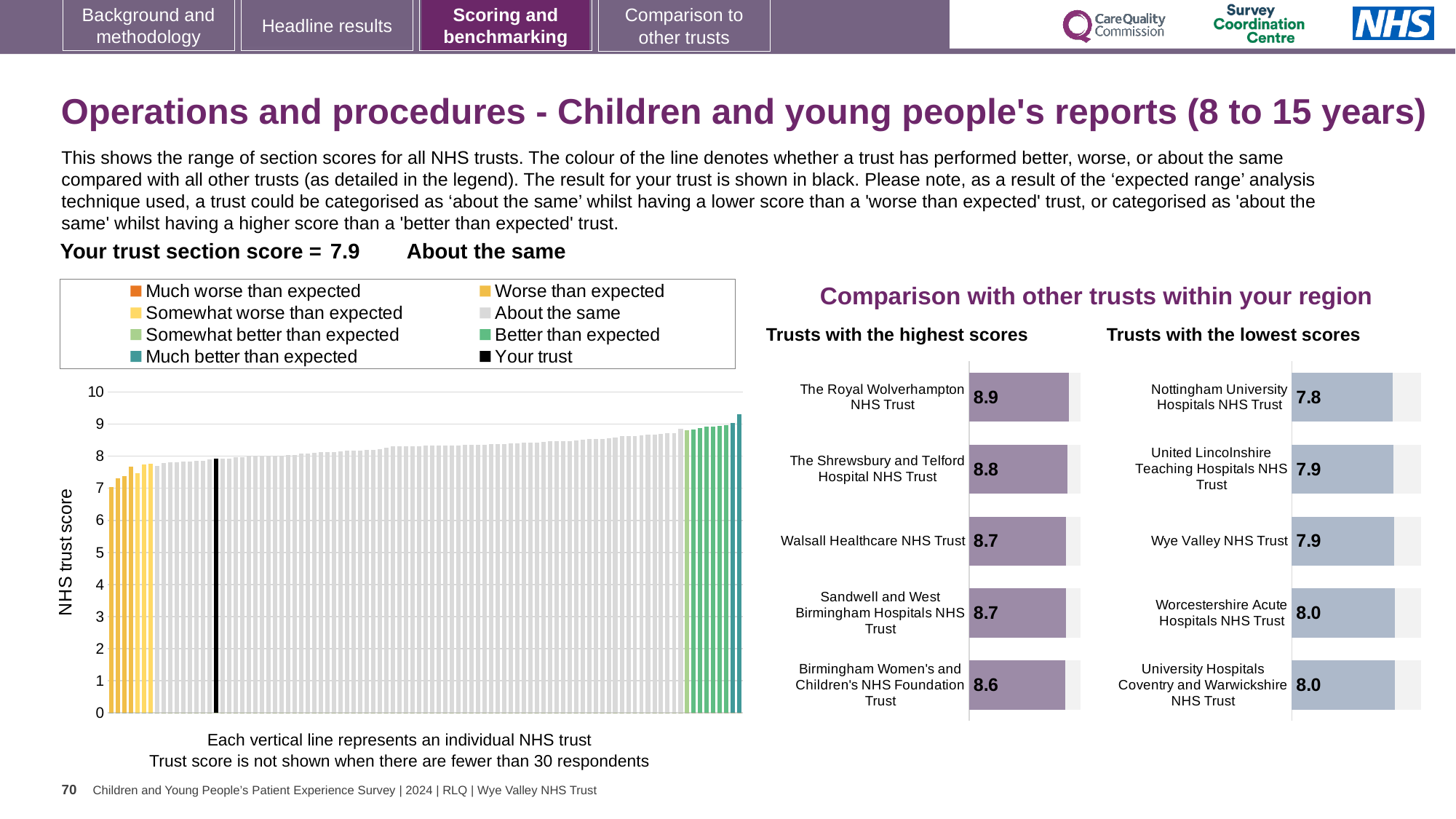
In the 'Trusts with the lowest scores' chart, what is the score for Worcestershire Acute Hospitals NHS Trust? 8.0 In the large 'NHS trust score' bar chart on the left, do the bar values rise or fall from left to right? rise What type of chart is the large chart on the left with the y-axis labelled 'NHS trust score'? bar chart In the 'Trusts with the lowest scores' chart, which trust has the lowest score? Nottingham University Hospitals NHS Trust In the 'Trusts with the highest scores' chart, what is the score for Birmingham Women's and Children's NHS Foundation Trust? 8.6 Which is larger: the score for The Shrewsbury and Telford Hospital NHS Trust in the 'highest scores' chart or the score for Wye Valley NHS Trust in the 'lowest scores' chart? The Shrewsbury and Telford Hospital NHS Trust How many trusts are shown in the 'Trusts with the lowest scores' chart? 5 In the 'Trusts with the lowest scores' chart, what is the score for Nottingham University Hospitals NHS Trust? 7.8 In the large 'NHS trust score' bar chart on the left, is the value of the lowest (leftmost) bar greater or less than 8? less In the 'Trusts with the highest scores' chart, what is the score for The Royal Wolverhampton NHS Trust? 8.9 In the 'Trusts with the highest scores' chart, what is the difference between the scores of The Royal Wolverhampton NHS Trust and Birmingham Women's and Children's NHS Foundation Trust? 0.3 In the 'Trusts with the highest scores' chart, which trust has the highest score? The Royal Wolverhampton NHS Trust